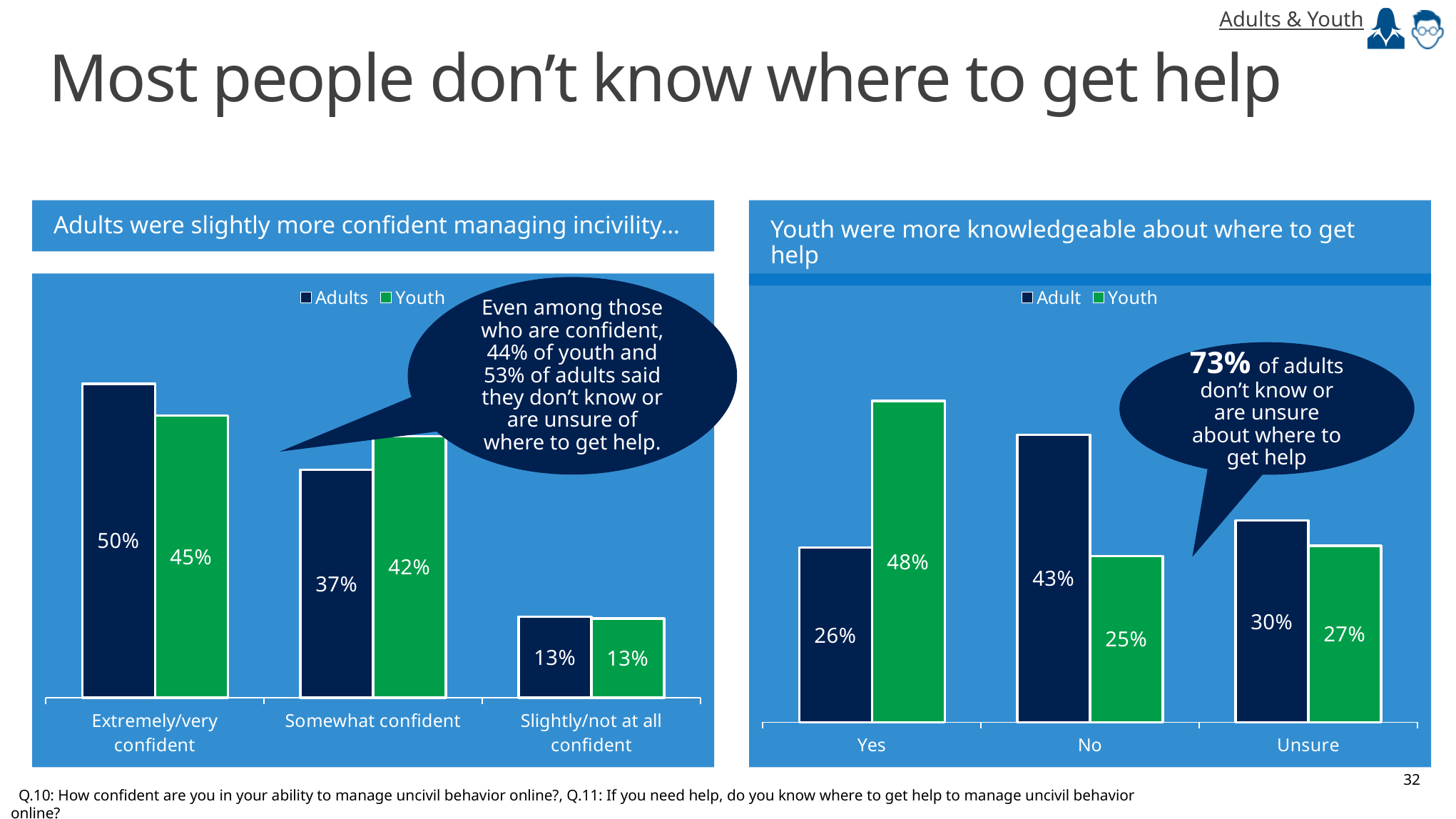
In the right chart (Youth were more knowledgeable about where to get help), which category has the highest value for Adult? No In the left chart (Adults were slightly more confident managing incivility...), what is the value for Adults in the Extremely/very confident category? 50% What kind of chart is the right chart (Youth were more knowledgeable about where to get help)? Bar chart In the right chart (Youth were more knowledgeable about where to get help), what is the value for Adult in the Unsure category? 30% In the right chart (Youth were more knowledgeable about where to get help), which is larger in the No category, Adult or Youth? Adult In the left chart (Adults were slightly more confident managing incivility...), what is the value for Youth in the Somewhat confident category? 42% In the right chart (Youth were more knowledgeable about where to get help), what is the value for Youth in the Yes category? 48% In the left chart (Adults were slightly more confident managing incivility...), what is the difference between Adults and Youth in the Extremely/very confident category? 5% In the left chart (Adults were slightly more confident managing incivility...), how many categories are shown on the x axis? 3 In the left chart (Adults were slightly more confident managing incivility...), how many series does the legend list? 2 In the right chart (Youth were more knowledgeable about where to get help), what is the difference between Youth and Adult in the Yes category? 22% In the left chart (Adults were slightly more confident managing incivility...), which category has the lowest value for Adults? Slightly/not at all confident